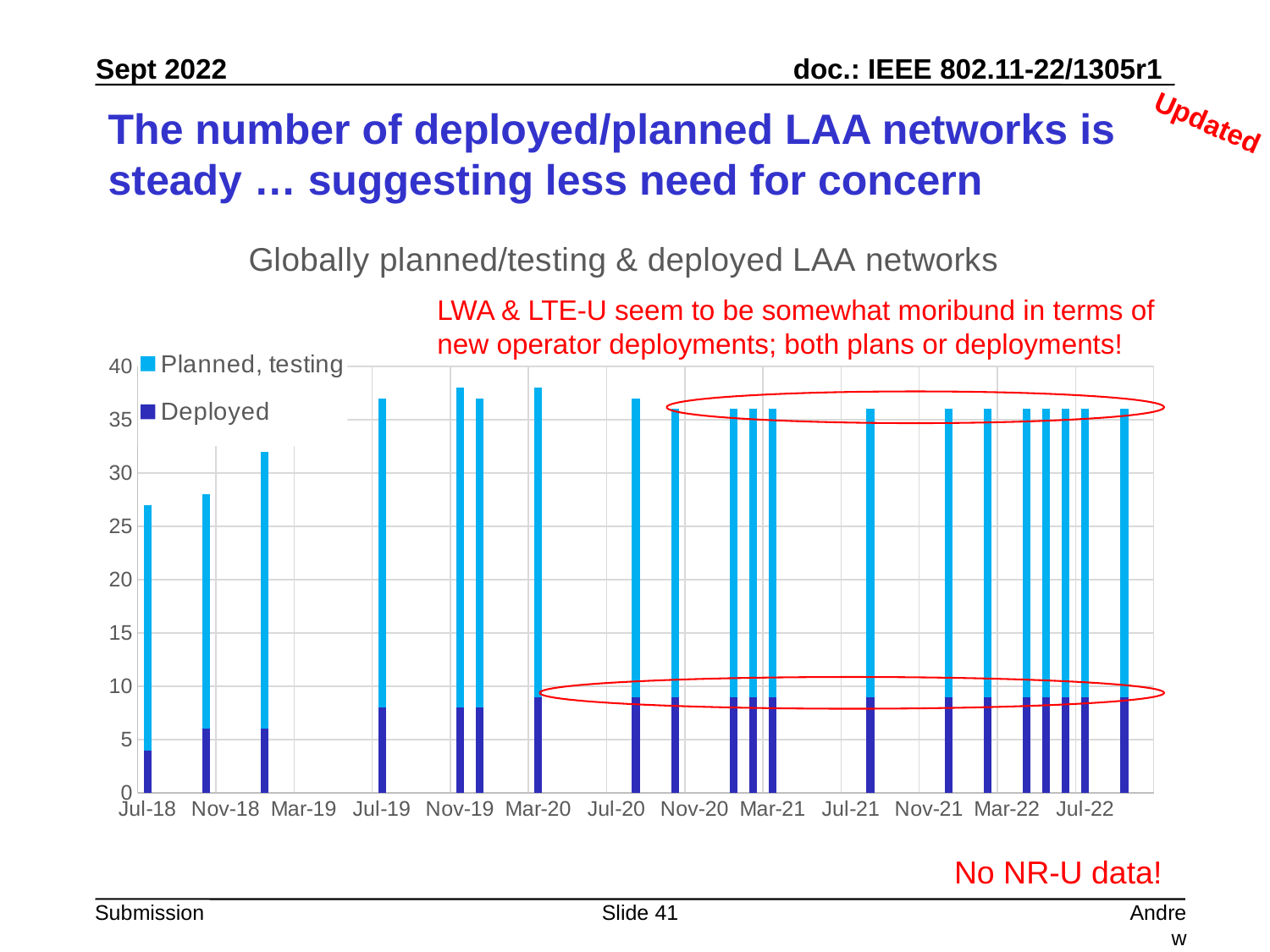
Does the Deployed value rise or fall from Jul-18 to Jul-22? rise Which series is drawn at the bottom of each stacked bar? Deployed Is the total height of the Jul-22 bar greater or less than 30? greater What is the title of the chart? Globally planned/testing & deployed LAA networks Is the Deployed value for Jul-22 greater or less than 10? less What kind of chart is shown on the slide? Stacked bar chart How many series does the chart legend list? 2 Is the Deployed value for Jul-18 greater or less than 5? less Which bar is taller in total, Jul-18 or Jul-22? Jul-22 Does the total number of networks rise or fall from Jul-18 to Jul-22? rise